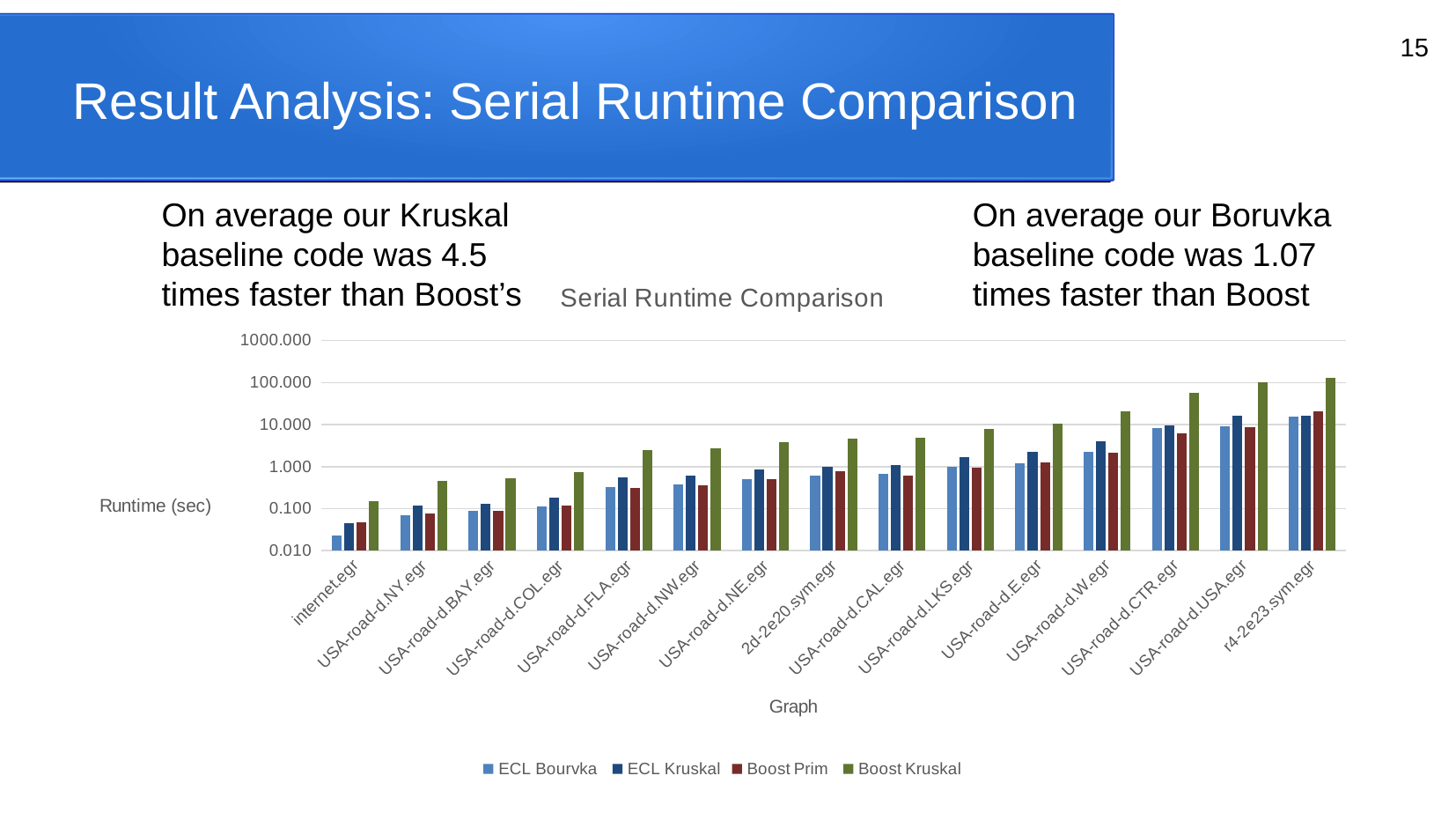
What is the title of the chart? Serial Runtime Comparison How many series does the legend of the Serial Runtime Comparison chart list? 4 What kind of chart is shown on the slide? Bar chart Is the Boost Kruskal value for USA-road-d.CTR.egr greater or less than 100.000? less Is the ECL Bourvka value for internet.egr greater or less than 0.100? less For USA-road-d.W.egr, which is larger: the Boost Kruskal value or the ECL Bourvka value? Boost Kruskal For which graph is the Boost Kruskal bar the tallest? r4-2e23.sym.egr How many graphs (categories) are plotted along the x axis of the Serial Runtime Comparison chart? 15 Which series has the highest bar for USA-road-d.CTR.egr? Boost Kruskal What is the label of the vertical axis of the chart? Runtime (sec) Which series has the lowest bar for internet.egr? ECL Bourvka Is the Boost Kruskal value for USA-road-d.W.egr greater or less than 10.000? greater